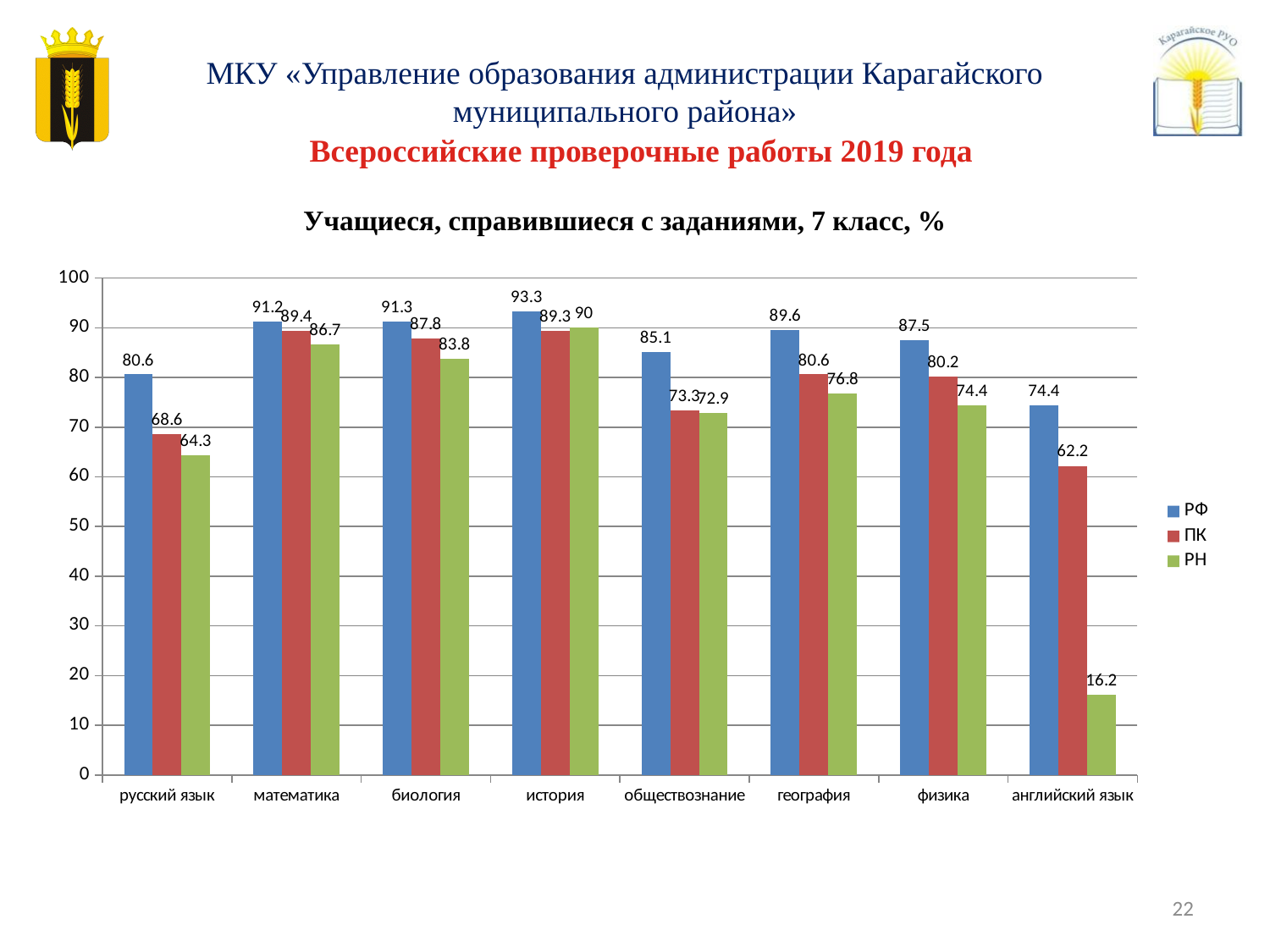
What is the value for ПК in обществознание? 73.3 How many subjects are shown on the x axis? 8 What is the difference between the РФ and РН values for английский язык? 58.2 How many series does the legend list? 3 What is the value for РФ in история? 93.3 Which is larger for география: the ПК value or the РН value? ПК What is the difference between the РФ and ПК values for русский язык? 12 What is the value for РН in английский язык? 16.2 Which subject has the highest РФ value? история What kind of chart is shown on the slide? bar chart Which subject has the lowest РН value? английский язык What is the title of the chart? Учащиеся, справившиеся с заданиями, 7 класс, %